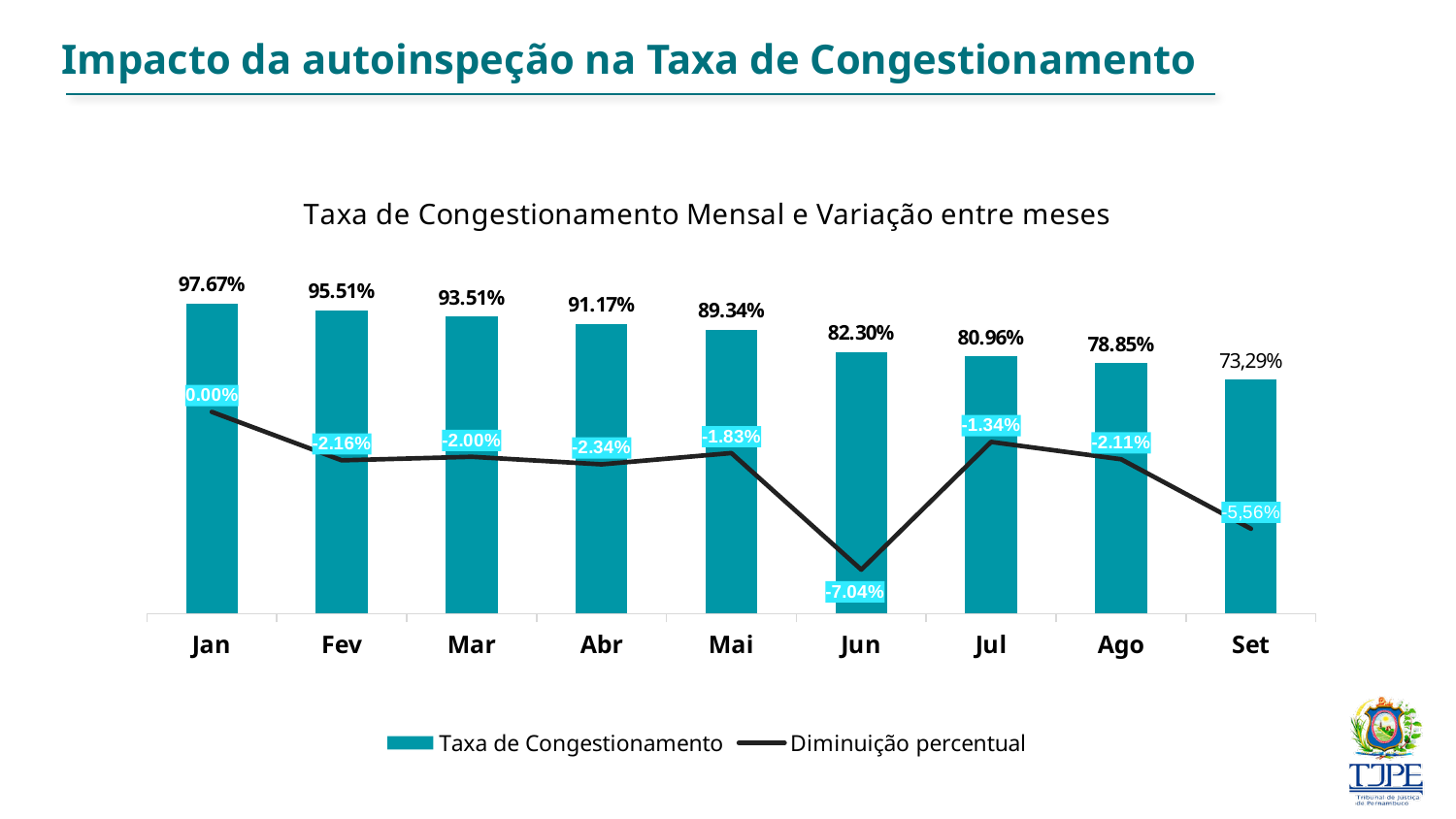
How many months are shown on the x axis? 9 How many series does the legend list? 2 What is the Taxa de Congestionamento for Jun? 82.30% What is the difference between the Taxa de Congestionamento for Jan and Fev? 2.16% Does the Taxa de Congestionamento rise or fall from Jan to Set? fall What is the Diminuição percentual value for Jun? -7.04% What is the Taxa de Congestionamento for Jan? 97.67% Which month has the lowest Diminuição percentual value? Jun Which month has the highest Taxa de Congestionamento? Jan What is the Diminuição percentual value for Set? -5,56% What is the Taxa de Congestionamento for Set? 73,29% Which is larger, the Taxa de Congestionamento for Mai or for Jul? Mai